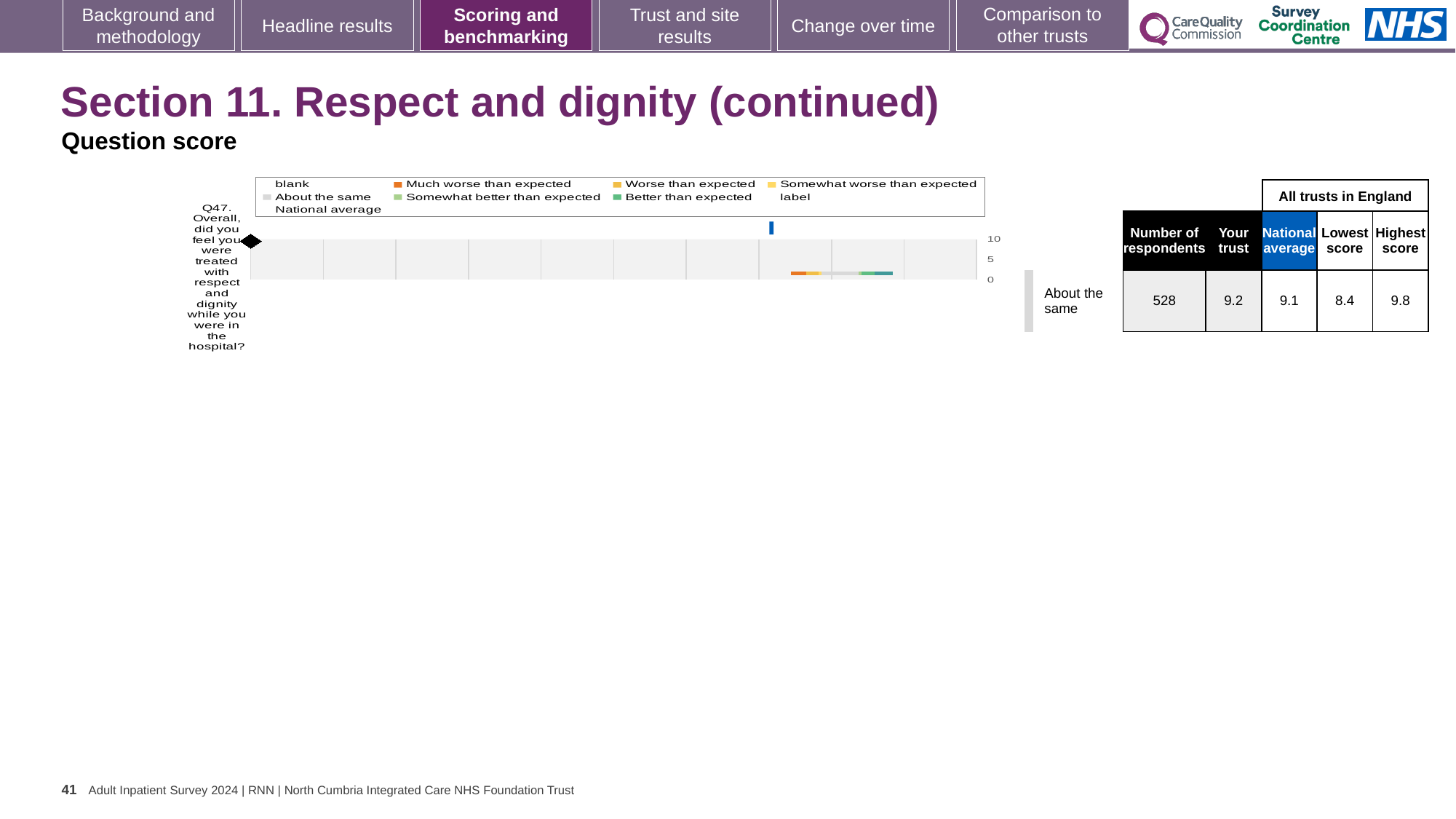
What is the national average score for Q47? 9.1 By how much does the 'Your trust' score for Q47 exceed the national average? 0.1 Which is larger for Q47: the 'Your trust' score or the national average? Your trust What is the lowest score among all trusts in England for Q47? 8.4 Which benchmarking category is Q47 placed in for this trust? About the same What is the difference between the highest and lowest scores for Q47 across all trusts in England? 1.4 How many respondents are shown for Q47 (Overall, did you feel you were treated with respect and dignity while you were in the hospital?)? 528 What is the 'Your trust' score for Q47? 9.2 How far below the highest score in England is the 'Your trust' score for Q47? 0.6 What is the highest score among all trusts in England for Q47? 9.8 What is the highest tick value shown on the chart's score axis? 10 Is the 'Your trust' score for Q47 greater or less than 5? greater